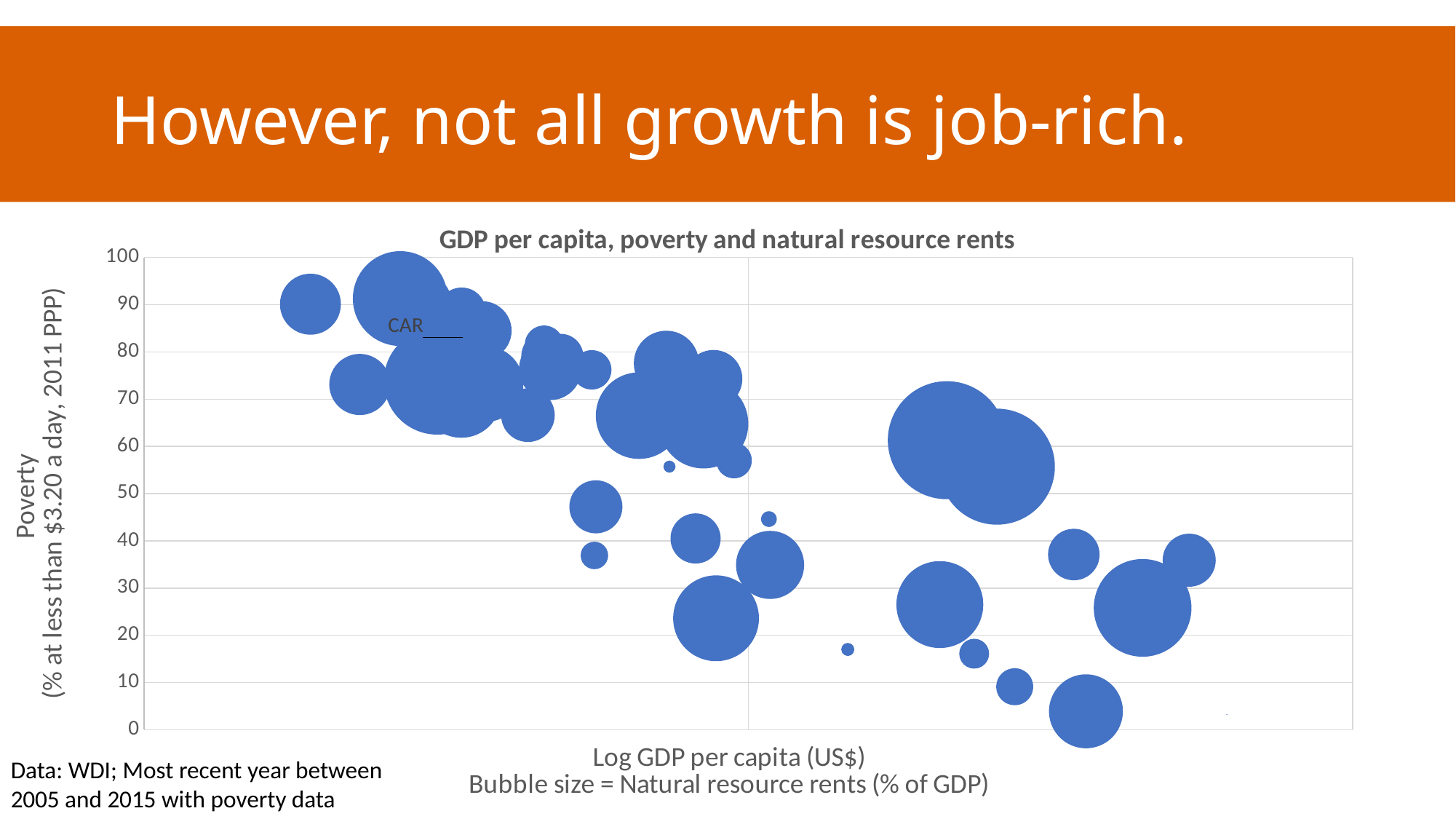
Is the poverty value for CAR greater or less than 50? greater What does the bubble size represent in the chart? Natural resource rents (% of GDP) As log GDP per capita increases along the x axis, does poverty generally rise or fall? Fall What kind of chart is shown on the slide? Bubble chart What is the highest value shown on the y axis of the chart? 100 What is the title of the chart? GDP per capita, poverty and natural resource rents